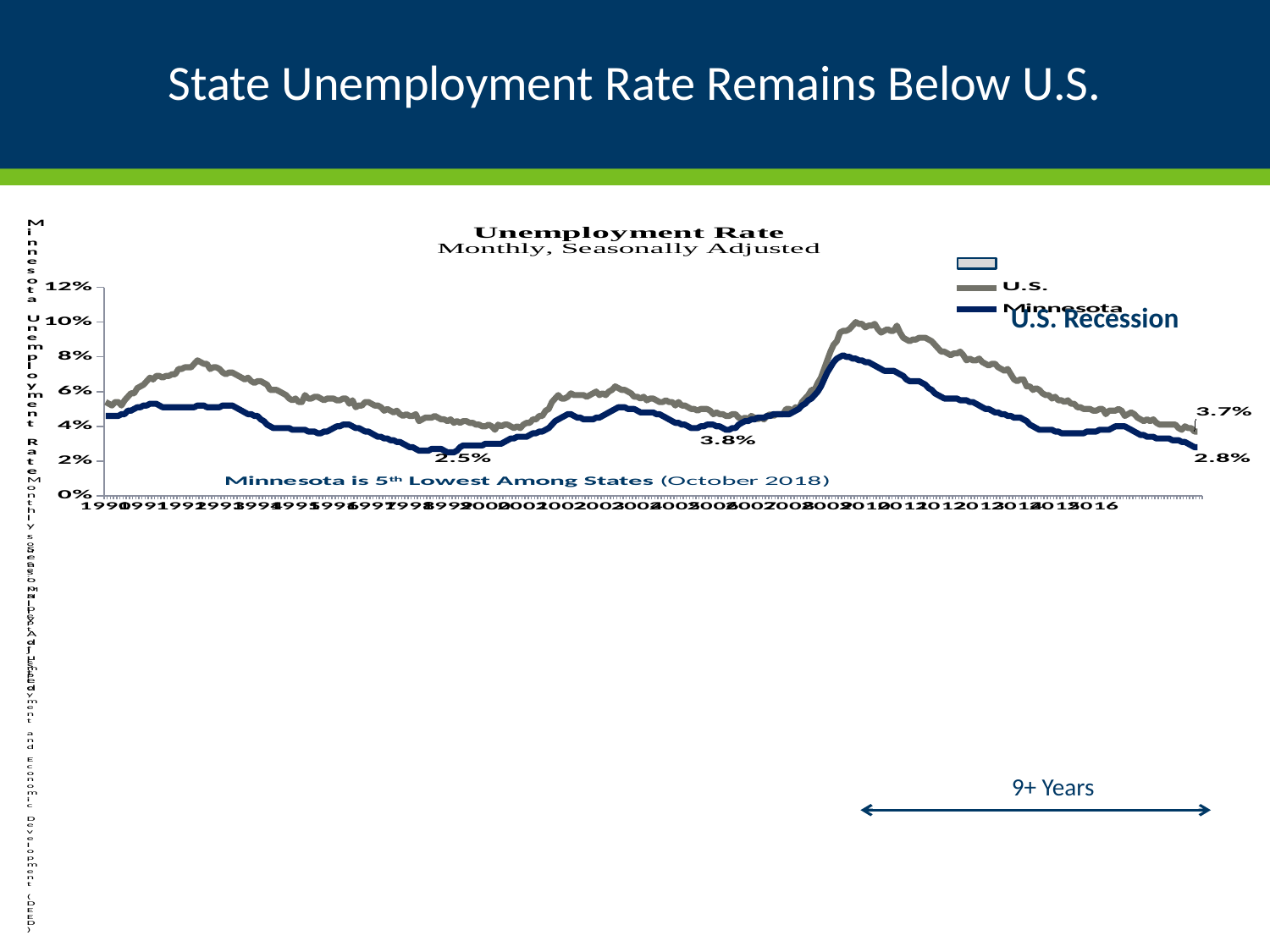
Does the U.S. unemployment rate rise or fall from 2010 to 2016? Fall What is the lowest value labeled on the Minnesota line, reached around 1999? 2.5% What is the difference between the latest labeled U.S. rate (3.7%) and the latest labeled Minnesota rate (2.8%)? 0.9 percentage points How many lines (series) are plotted on the chart? 2 Is the peak of the U.S. line around 2009-2010 greater or less than 8%? greater Which series is drawn in gray on the chart? U.S. What is the title of the chart? Unemployment Rate, Monthly, Seasonally Adjusted At the right end of the chart, which series has the higher unemployment rate, U.S. or Minnesota? U.S. What kind of chart is shown on the slide? Line chart What is the most recent U.S. unemployment rate labeled at the right end of the chart? 3.7% What is the most recent Minnesota unemployment rate labeled at the right end of the chart? 2.8% Is the peak of the Minnesota line around 2009 greater or less than 6%? greater